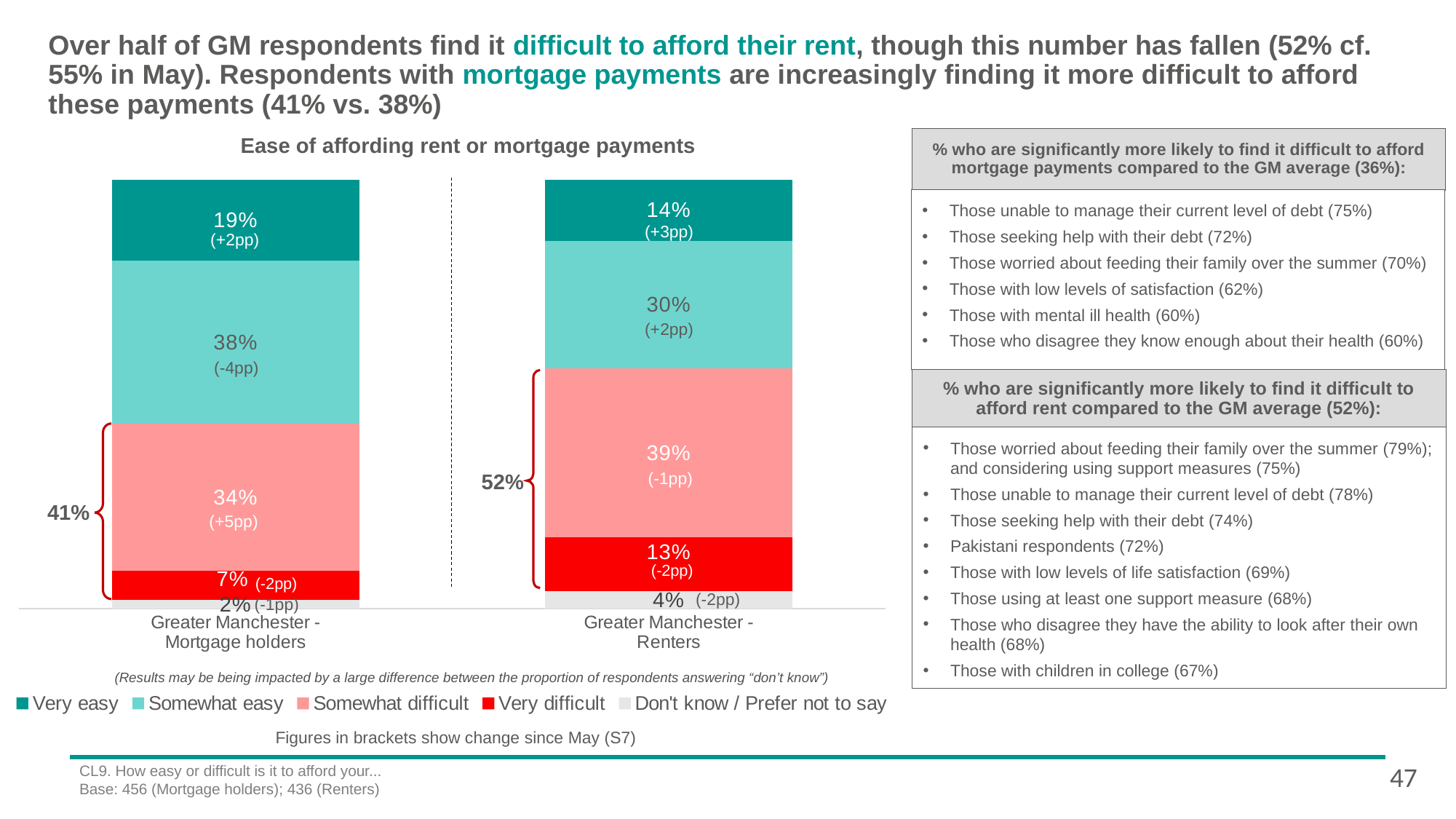
What is the difference between the 'Very difficult' values for Renters and Mortgage holders? 6 percentage points Which segment is the largest in the Greater Manchester - Renters bar? Somewhat difficult What kind of chart is shown on the slide? Stacked bar chart What is the 'Very difficult' value for Greater Manchester - Renters? 13% What is the 'Somewhat easy' value for Greater Manchester - Mortgage holders? 38% How many categories are plotted on the x axis? 2 How many series does the legend list? 5 What is the change since May shown in brackets for 'Somewhat difficult' among Mortgage holders? +5pp Which category has the higher 'Somewhat difficult' value, Mortgage holders or Renters? Renters What is the 'Don't know / Prefer not to say' value for Greater Manchester - Mortgage holders? 2% What is the chart's title? Ease of affording rent or mortgage payments What is the 'Very easy' value for Greater Manchester - Renters? 14%